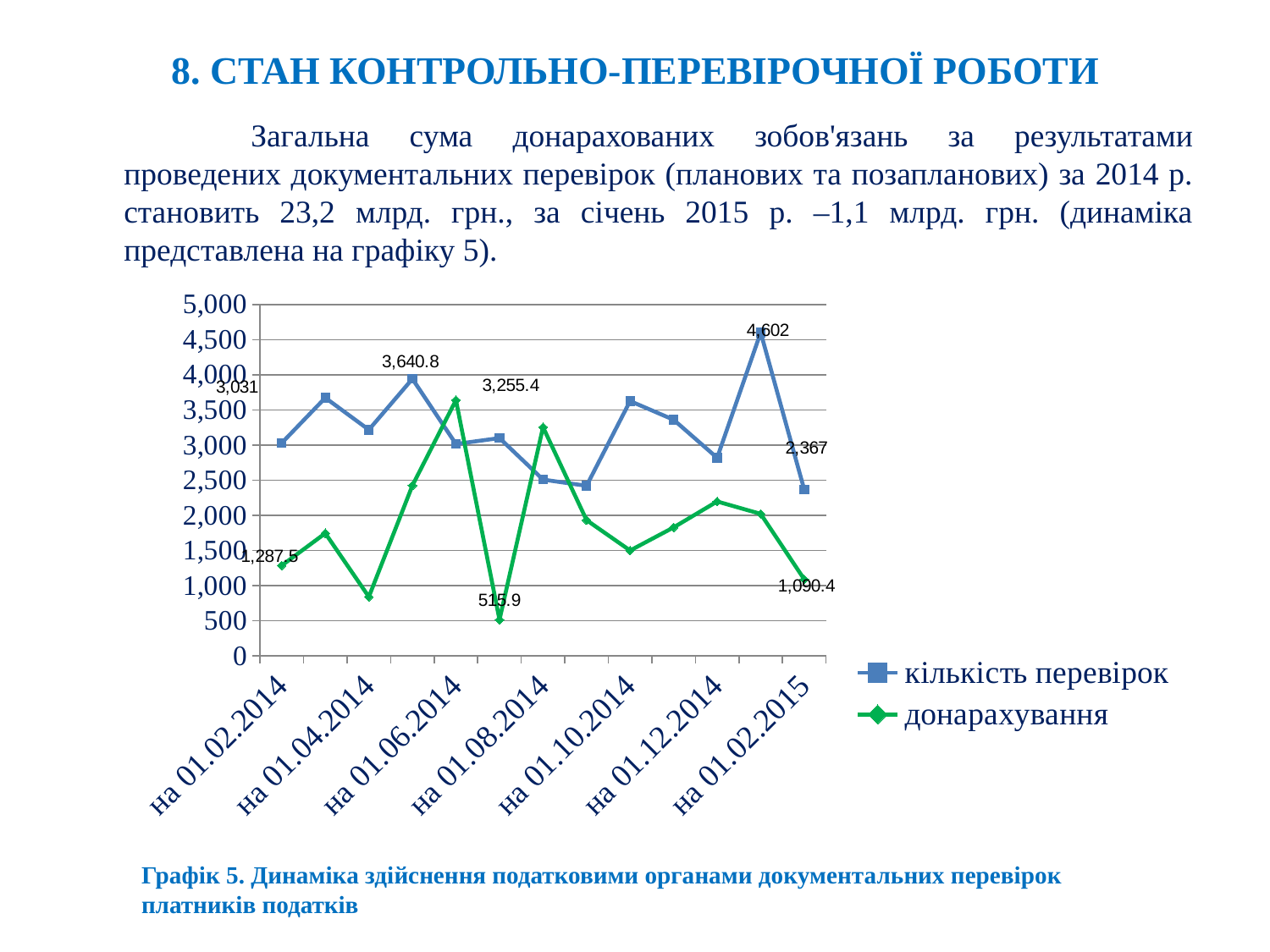
What is the value of донарахування на 01.02.2015? 1,090.4 What is the value of кількість перевірок на 01.02.2015? 2,367 What is the lowest labelled value of the донарахування series? 515.9 How many series does the chart legend list? 2 Is the value of донарахування на 01.04.2014 greater or less than 1,000? less What type of chart is shown on the slide? line chart What is the highest labelled value of the кількість перевірок series? 4,602 Which series has the larger value на 01.02.2015: кількість перевірок or донарахування? кількість перевірок What is the value of донарахування на 01.02.2014? 1,287.5 What is the difference between кількість перевірок and донарахування на 01.02.2014? 1,743.5 What is the value of кількість перевірок на 01.02.2014? 3,031 How many date labels are shown on the x axis? 7